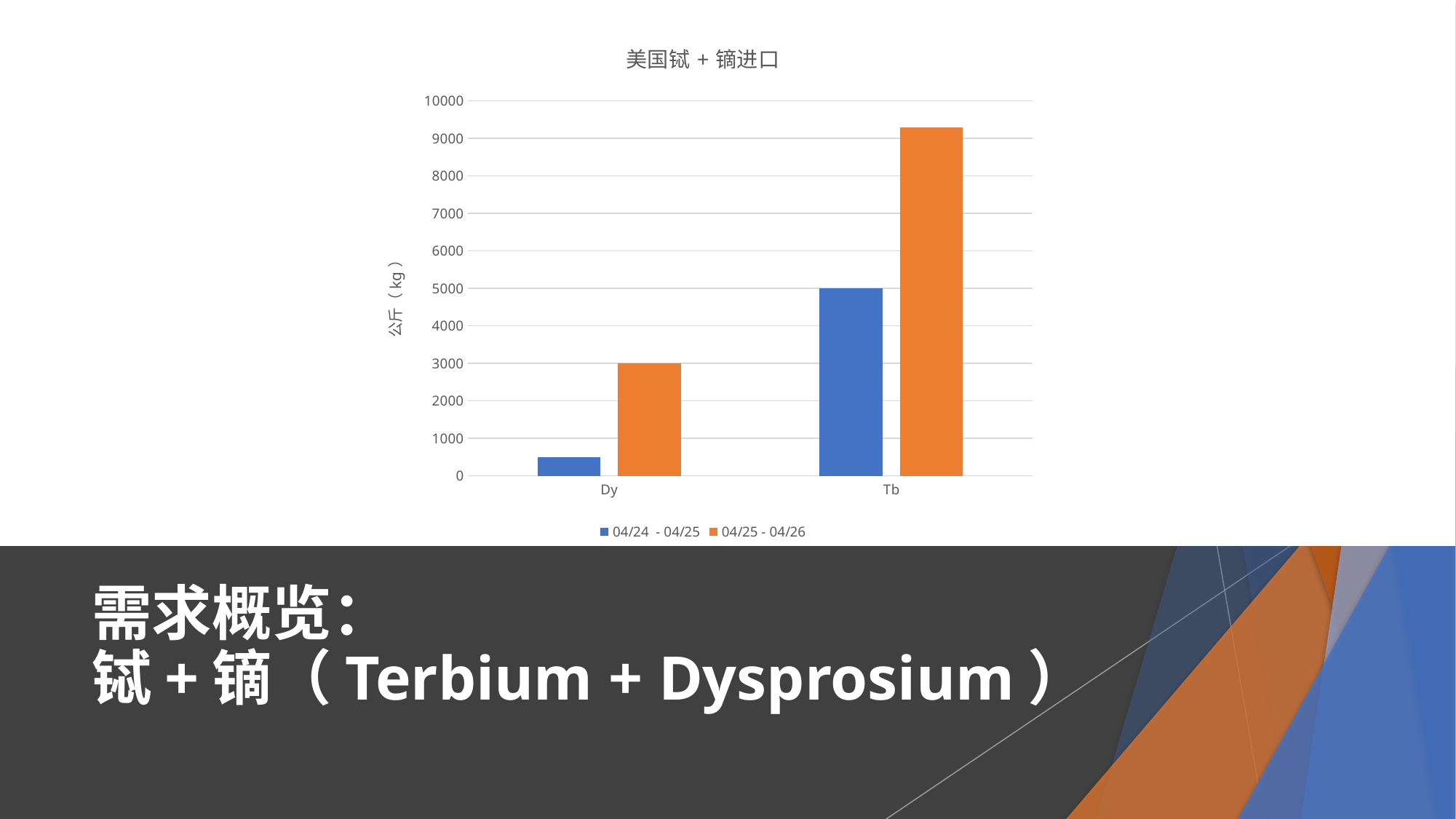
Which is larger: the 04/24 - 04/25 value for Tb or the 04/25 - 04/26 value for Dy? 04/24 - 04/25 value for Tb What is the value for Dy in the 04/25 - 04/26 series? 3000 Which category has the highest value in the 04/25 - 04/26 series? Tb What type of chart is shown on the slide? bar chart How many series does the legend list? 2 Is the value for Tb in the 04/25 - 04/26 series greater or less than 9000? greater Is the value for Dy in the 04/24 - 04/25 series greater or less than 1000? less How many categories are shown on the x axis? 2 What is the difference between the 04/24 - 04/25 value for Tb and the 04/25 - 04/26 value for Dy? 2000 What is the title of the chart? 美国铽 + 镝进口 What is the value for Tb in the 04/24 - 04/25 series? 5000 Which category has the lowest value in the 04/24 - 04/25 series? Dy